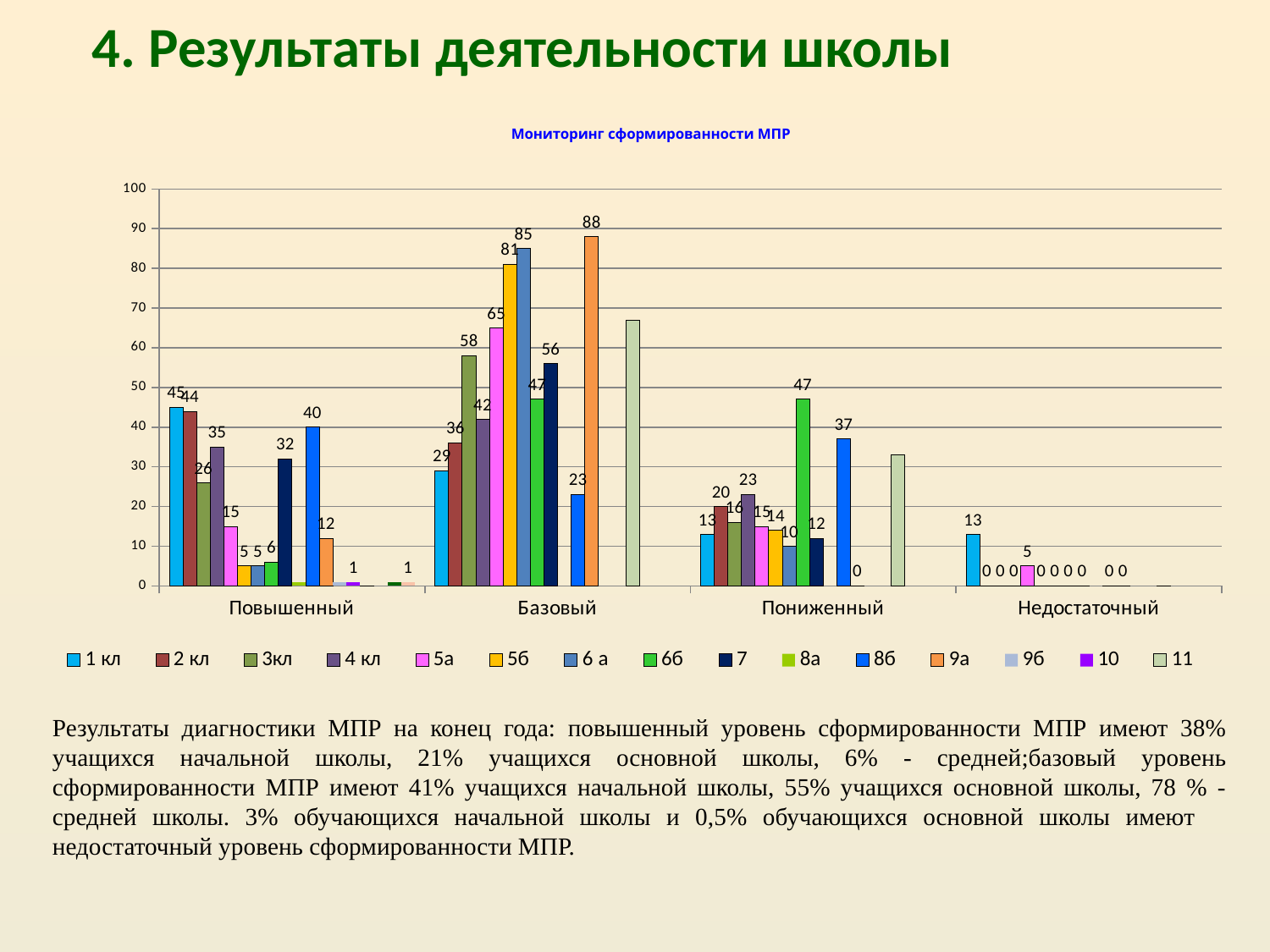
What is the difference between the values for 6 а and 5б in the Базовый category? 4 Which series has the highest value in the Базовый category? 9а What is the value for 6б in the Пониженный category? 47 What is the title of the chart? Мониторинг сформированности МПР In the Повышенный category, which is larger: the value for 8б or the value for 7? 8б What kind of chart is shown on the slide? Bar chart How many series does the chart legend list? 15 Is the value for 11 in the Базовый category greater or less than 60? greater What is the value for 9а in the Базовый category? 88 How many categories are shown on the x axis of the chart? 4 What is the value for 1 кл in the Повышенный category? 45 What is the value for 8б in the Пониженный category? 37